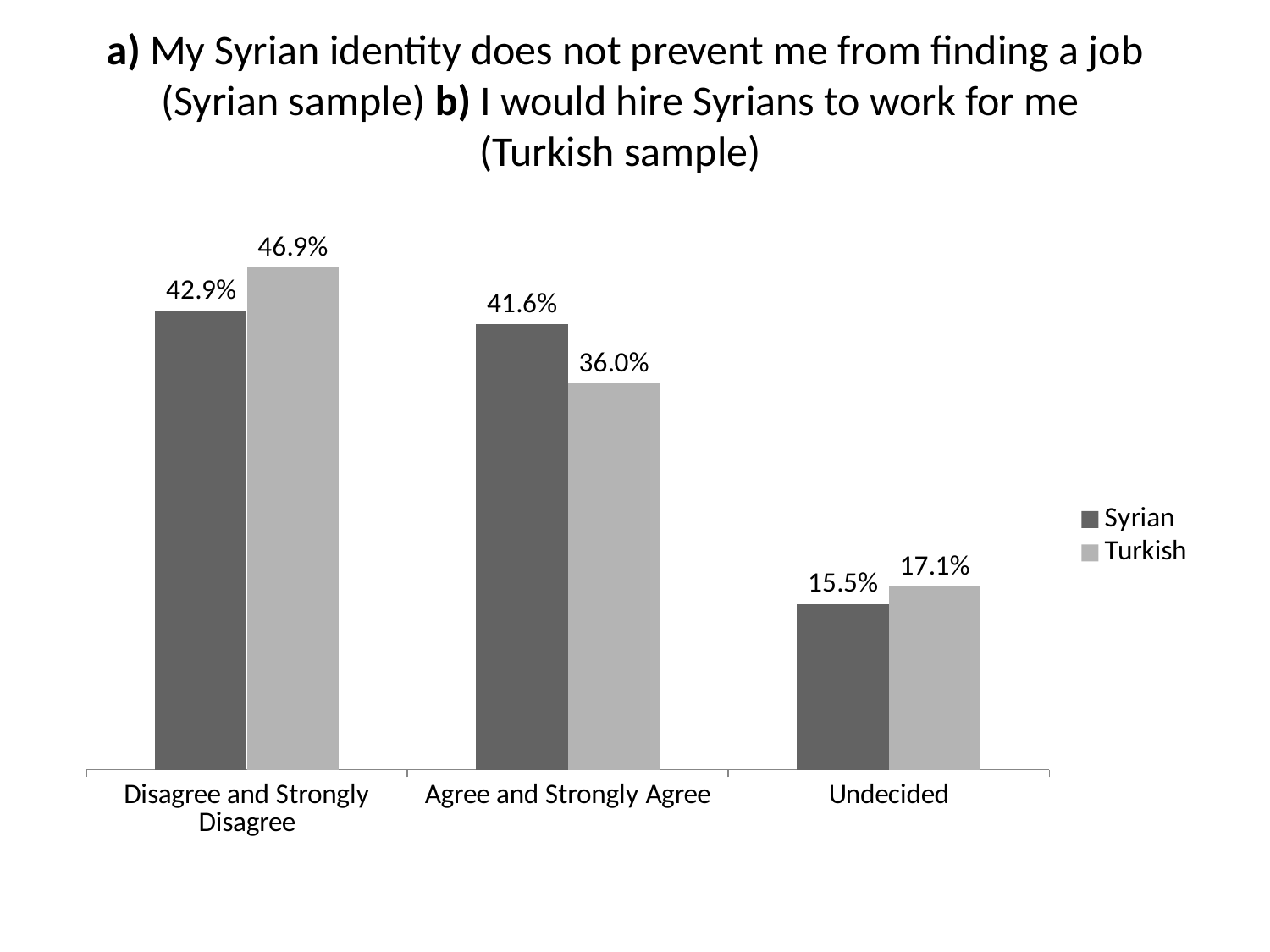
What is the difference between the Turkish and Syrian values in the Disagree and Strongly Disagree category? 4.0% How many categories are shown on the x axis? 3 What kind of chart is shown on the slide? Bar chart Which category has the highest value for the Turkish series? Disagree and Strongly Disagree What is the difference between the Syrian and Turkish values in the Agree and Strongly Agree category? 5.6% What is the value for the Turkish series in the Agree and Strongly Agree category? 36.0% In the Agree and Strongly Agree category, which series has the larger value, Syrian or Turkish? Syrian What is the value for the Syrian series in the Disagree and Strongly Disagree category? 42.9% Which category has the lowest value for the Syrian series? Undecided What is the value for the Turkish series in the Undecided category? 17.1% Which series is shown in the lighter grey colour? Turkish How many series does the legend list? 2